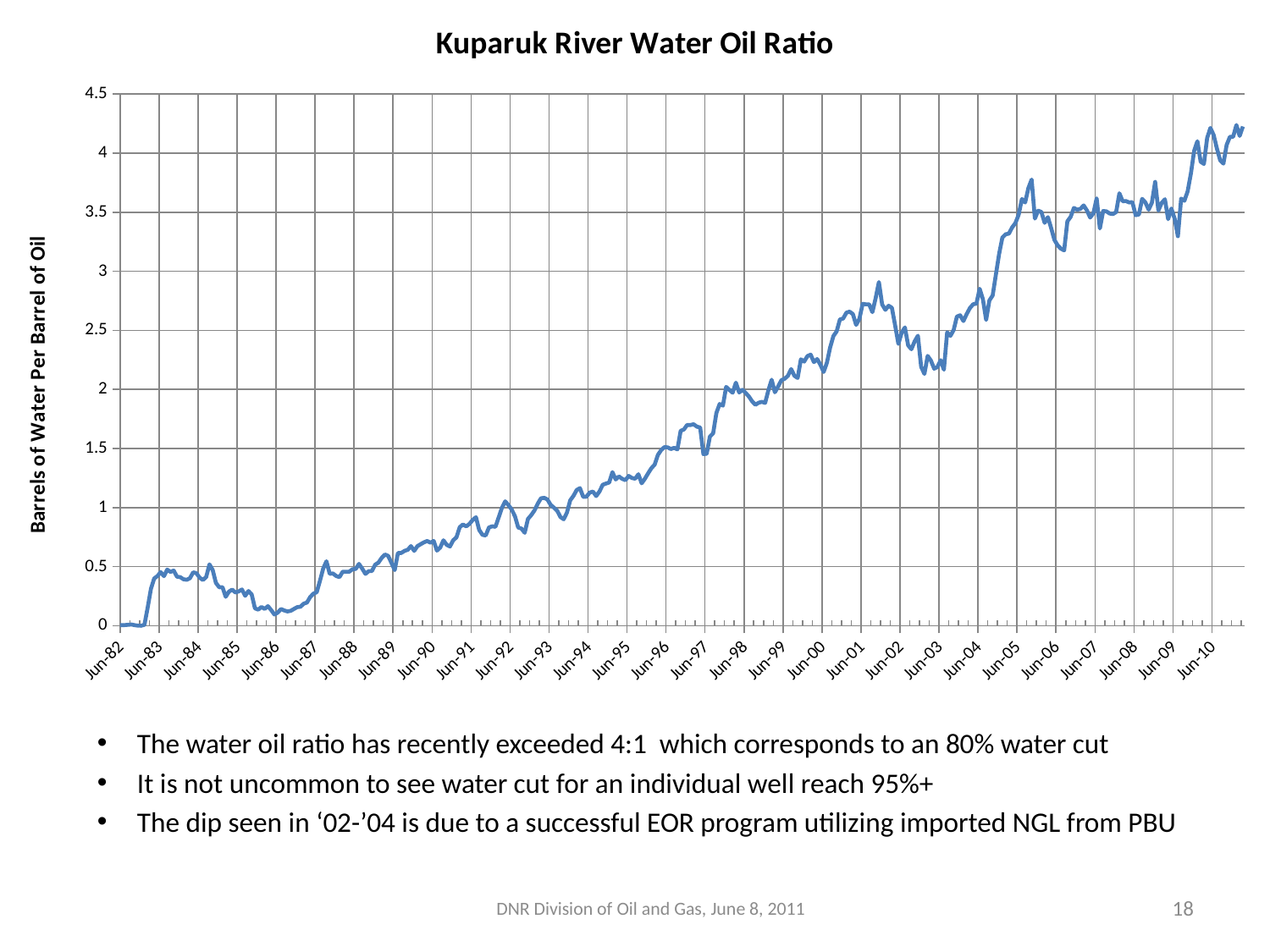
Which labelled year on the x axis has the lowest water oil ratio? Jun-82 What is the title of the chart? Kuparuk River Water Oil Ratio Is the value for Jun-05 greater or less than 3? greater Is the value for Jun-96 greater or less than 1? greater Is the value for Jun-86 greater or less than 0.5? less What is the label on the vertical axis of the chart? Barrels of Water Per Barrel of Oil Overall, does the water oil ratio rise or fall from Jun-82 to Jun-10? rise Which is larger, the value for Jun-05 or the value for Jun-95? Jun-05 What kind of chart is shown on the slide? line chart